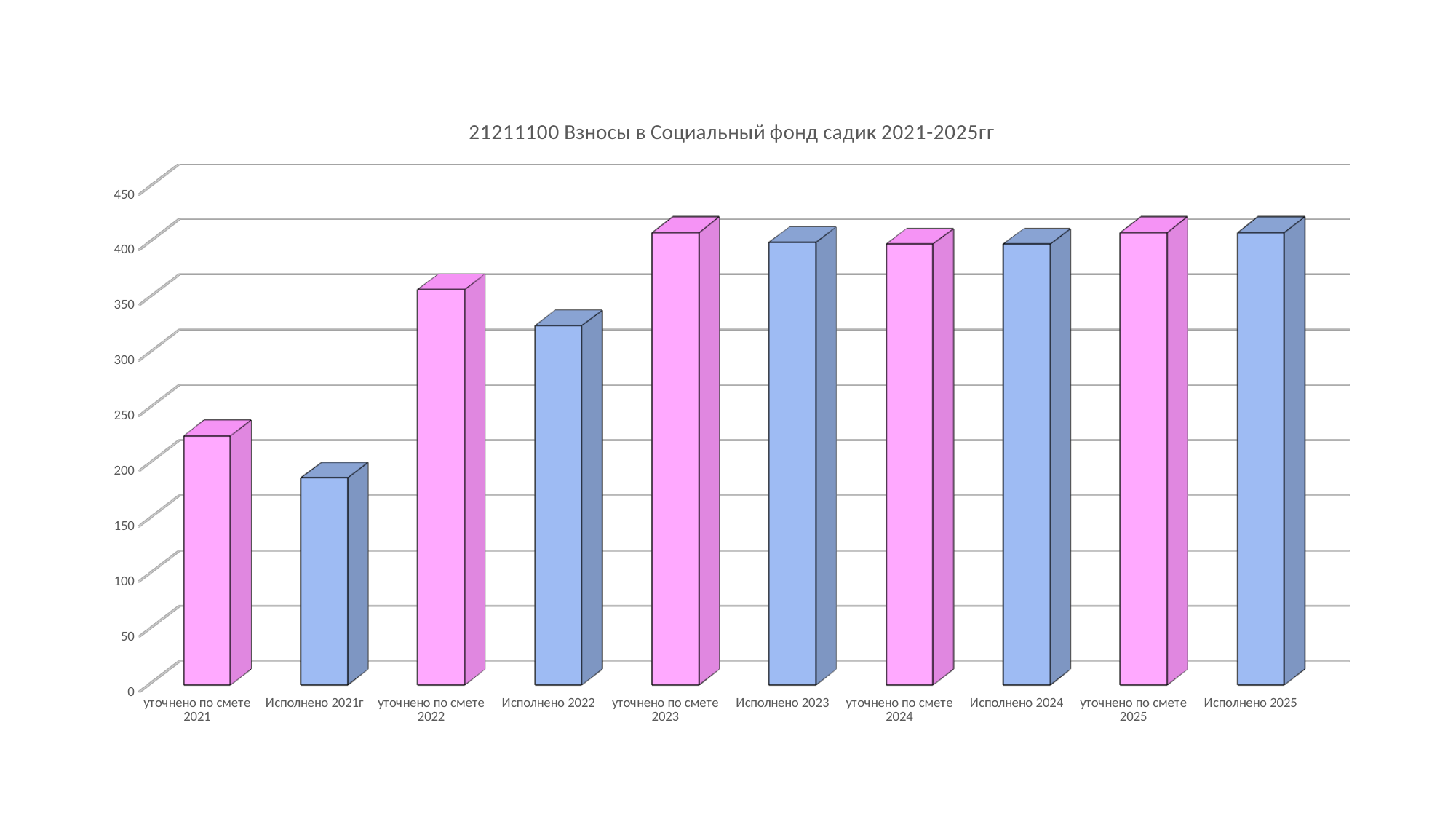
What is the title of the chart? 21211100 Взносы в Социальный фонд садик 2021-2025гг Is the value for "уточнено по смете 2022" greater or less than 350? greater Is the value for "Исполнено 2021г" greater or less than 200? less Is the value for "уточнено по смете 2021" greater or less than 250? less What kind of chart is shown on the slide? bar chart Do the values generally rise or fall from left to right along the x axis? rise Which is larger, the value for "уточнено по смете 2021" or the value for "Исполнено 2021г"? уточнено по смете 2021 How many categories are shown on the x axis of the chart? 10 Which is larger, the value for "Исполнено 2022" or the value for "Исполнено 2023"? Исполнено 2023 Which category has the lowest value in the chart? Исполнено 2021г